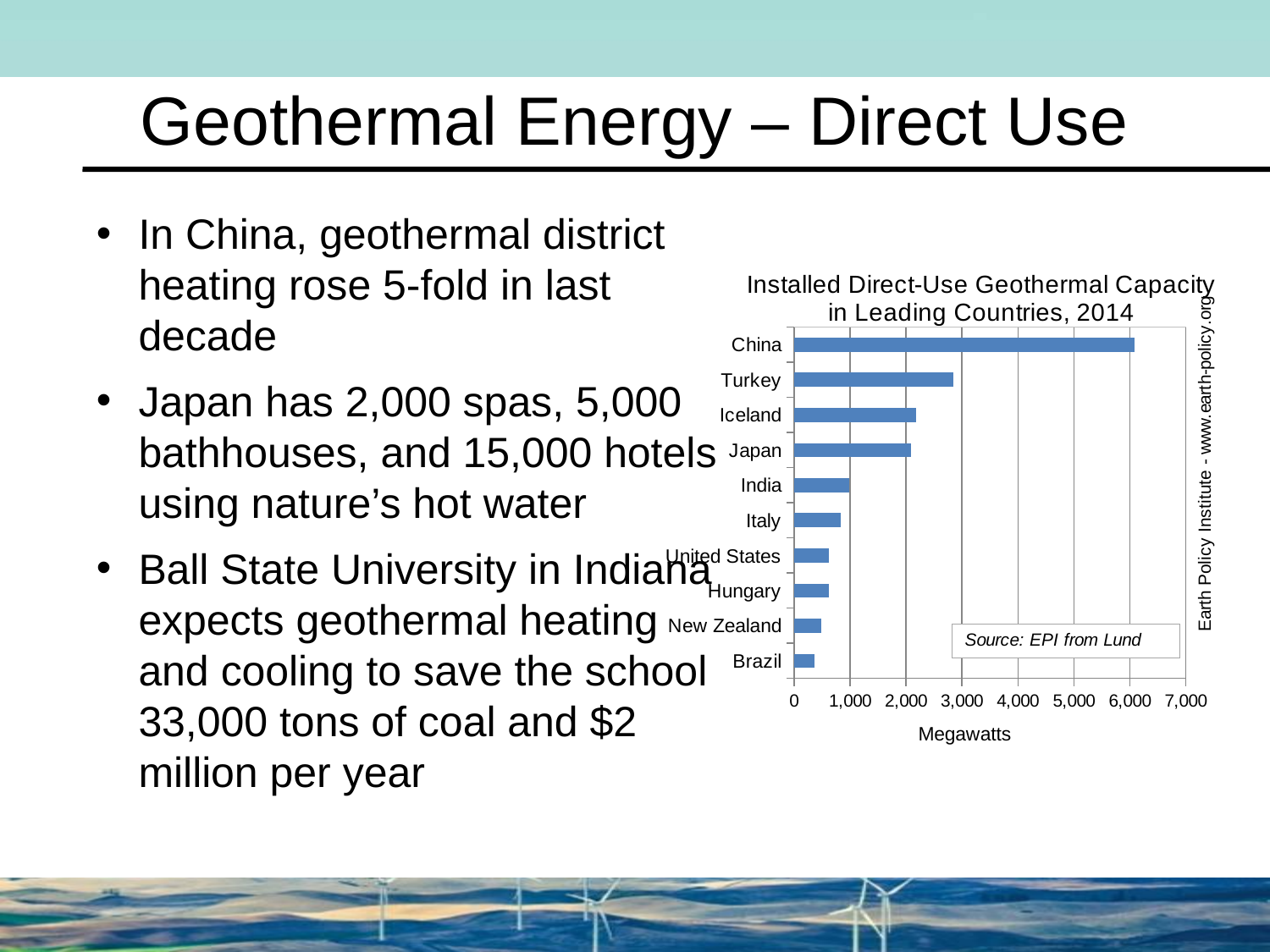
Is the value for Turkey greater or less than 2,000 megawatts? greater Is the value for Italy greater or less than 1,000 megawatts? less What is the title of the chart on the slide? Installed Direct-Use Geothermal Capacity in Leading Countries, 2014 Which has a larger installed direct-use geothermal capacity, China or Turkey? China How many countries are shown in the chart? 10 Is the value for China greater or less than 5,000 megawatts? greater Which country has the highest installed direct-use geothermal capacity in the chart? China What unit is shown on the horizontal axis of the chart? Megawatts Which country has the lowest installed direct-use geothermal capacity in the chart? Brazil What kind of chart is shown on the slide? bar chart Which has a larger installed direct-use geothermal capacity, Turkey or Iceland? Turkey Which has a larger installed direct-use geothermal capacity, Japan or India? Japan